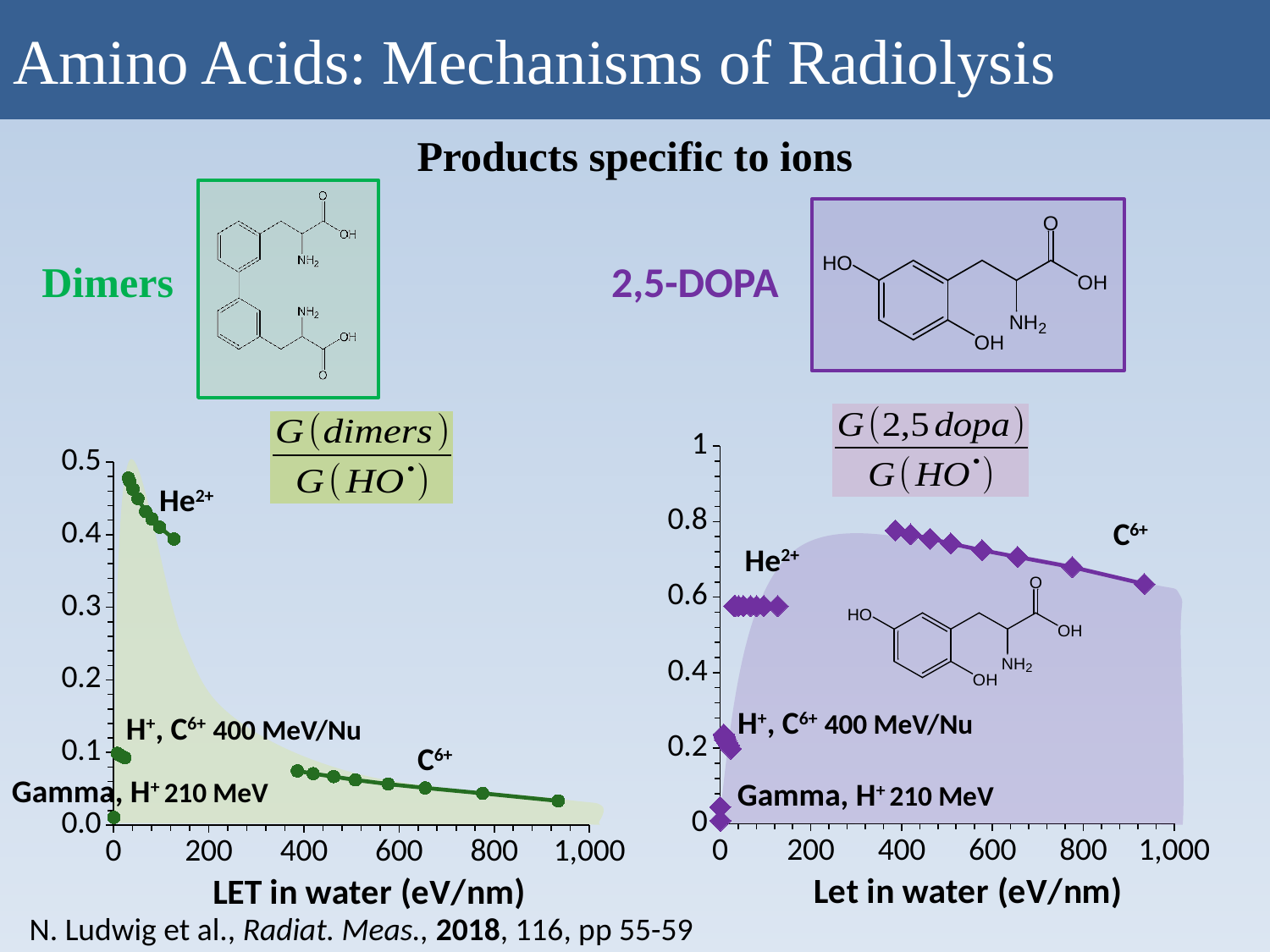
On the left chart (G(dimers)/G(HO•)), do the C6+ values rise or fall as LET increases? fall What is the x-axis label of the left chart (G(dimers)/G(HO•))? LET in water (eV/nm) On the right chart (G(2,5 dopa)/G(HO•)), do the C6+ values rise or fall as LET increases? fall On the left chart (G(dimers)/G(HO•)), are the C6+ values greater or less than 0.1? less On the right chart (G(2,5 dopa)/G(HO•)), are the C6+ values greater or less than 0.6? greater On the right chart (G(2,5 dopa)/G(HO•)), which group has higher values, C6+ or He2+? C6+ On the right chart (G(2,5 dopa)/G(HO•)), are the Gamma, H+ 210 MeV values greater or less than 0.2? less What is the highest y-axis tick value shown on the right chart (G(2,5 dopa)/G(HO•))? 1 What kind of chart is the left chart (G(dimers)/G(HO•))? scatter/line chart On the left chart (G(dimers)/G(HO•)), which group has higher values, He2+ or C6+? He2+